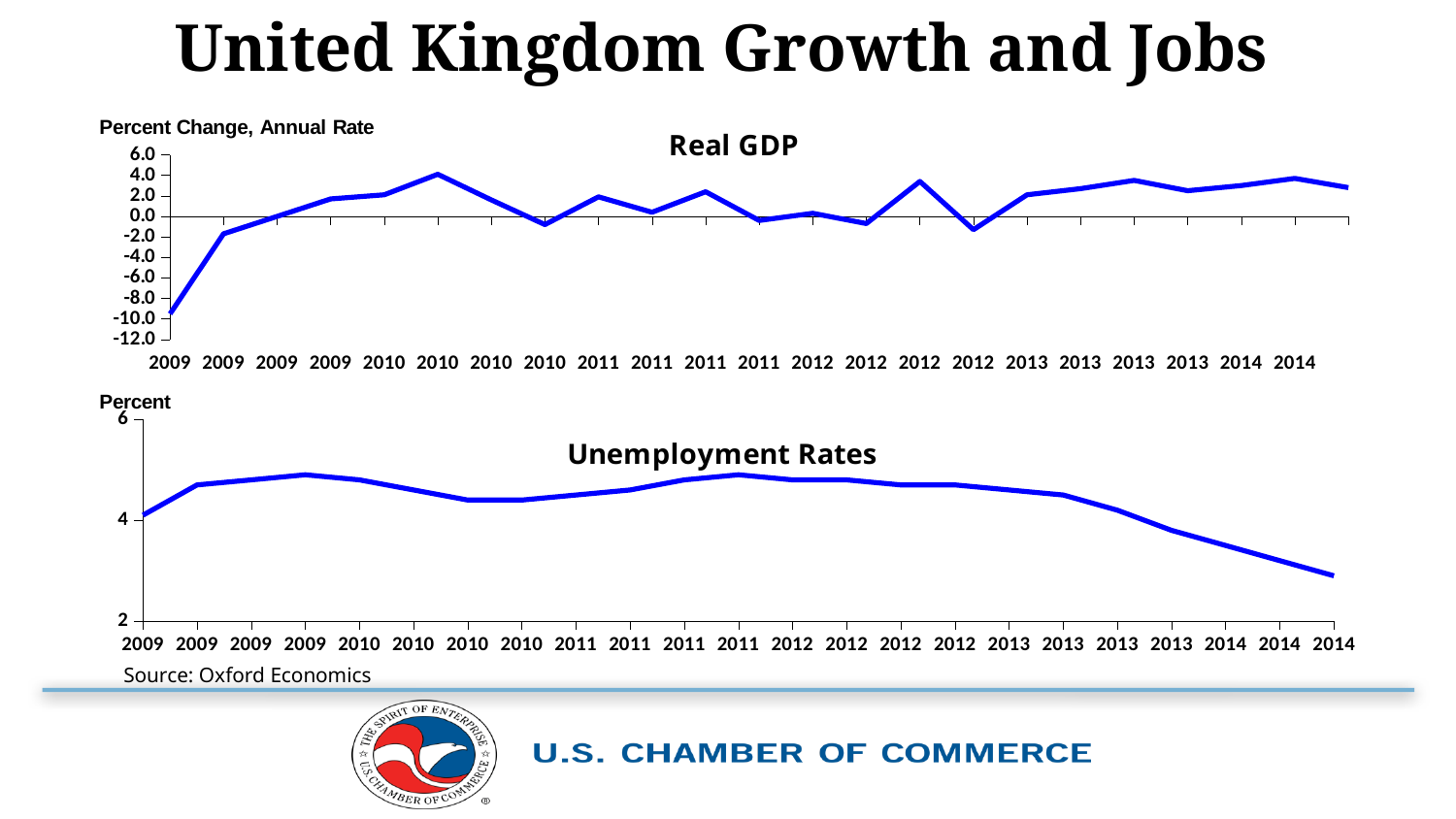
In the Real GDP chart, which point has the lowest value? the first 2009 point In the Unemployment Rates chart, is the value for the last 2014 point greater or less than 4? less What kind of chart is the Unemployment Rates chart? line chart What kind of chart is the Real GDP chart? line chart In the Unemployment Rates chart, do values rise or fall from 2013 to 2014? fall In the Unemployment Rates chart, is the highest 2011 value greater or less than 4? greater What is the y-axis label of the Real GDP chart? Percent Change, Annual Rate In the Real GDP chart, is the value for the first 2009 point greater or less than -8.0? less In the Unemployment Rates chart, which point has the lowest value? the last 2014 point How many data points are plotted in the Unemployment Rates chart? 23 In the Real GDP chart, do values rise or fall across the 2009 points? rise